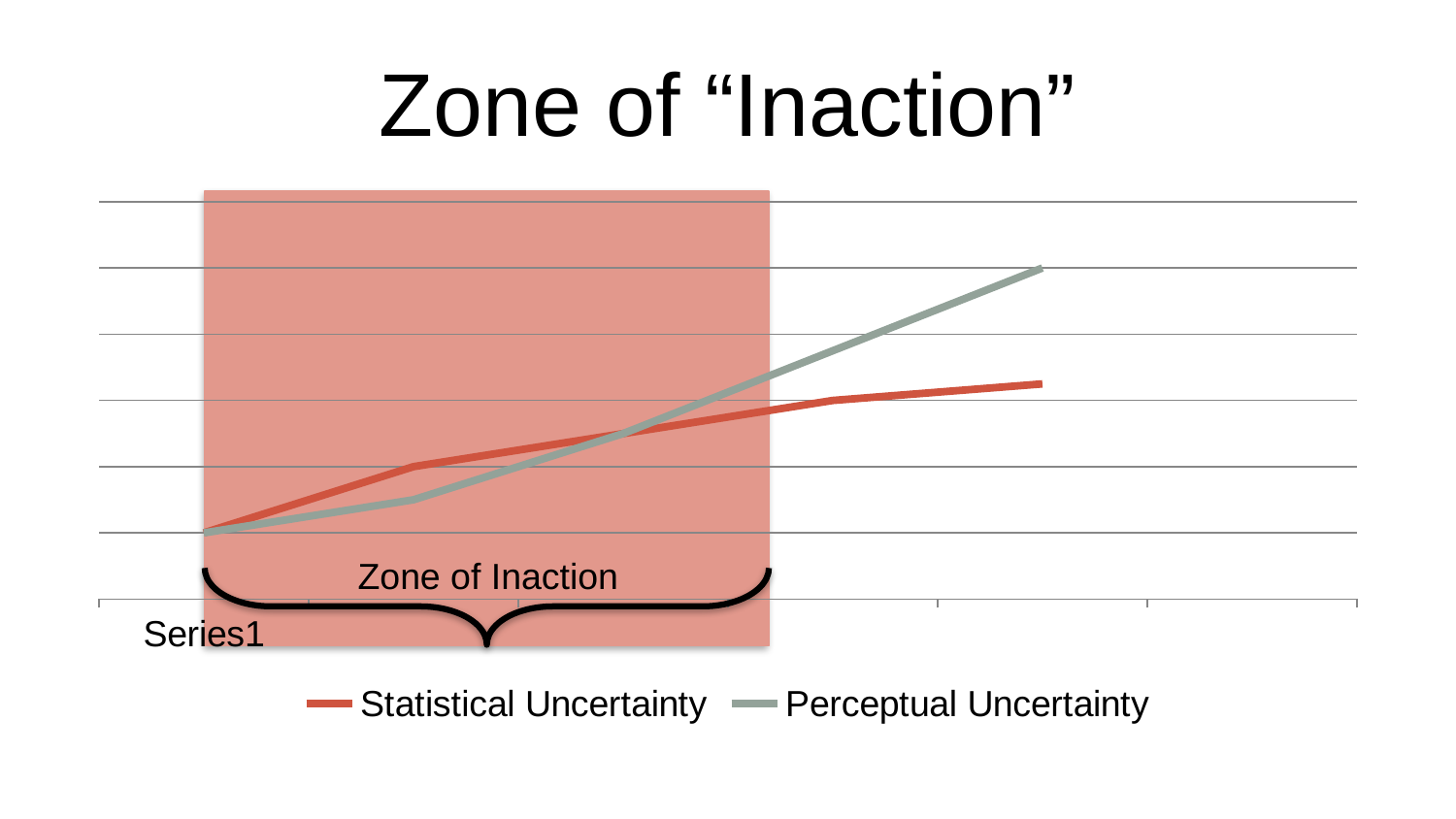
How many series does the legend list? 2 Near the left side of the shaded zone, which series has the higher value? Statistical Uncertainty Which series ends at the highest point on the chart? Perceptual Uncertainty What are the two series named in the legend? Statistical Uncertainty and Perceptual Uncertainty At the right end of the chart, which series has the higher value? Perceptual Uncertainty What label is shown on the x axis? Series1 Does the Statistical Uncertainty line rise or fall from left to right? rise Which series ends at the lowest point on the chart? Statistical Uncertainty Does the Perceptual Uncertainty line rise or fall from left to right? rise Which series is drawn in red? Statistical Uncertainty What kind of chart is shown on the slide? line chart